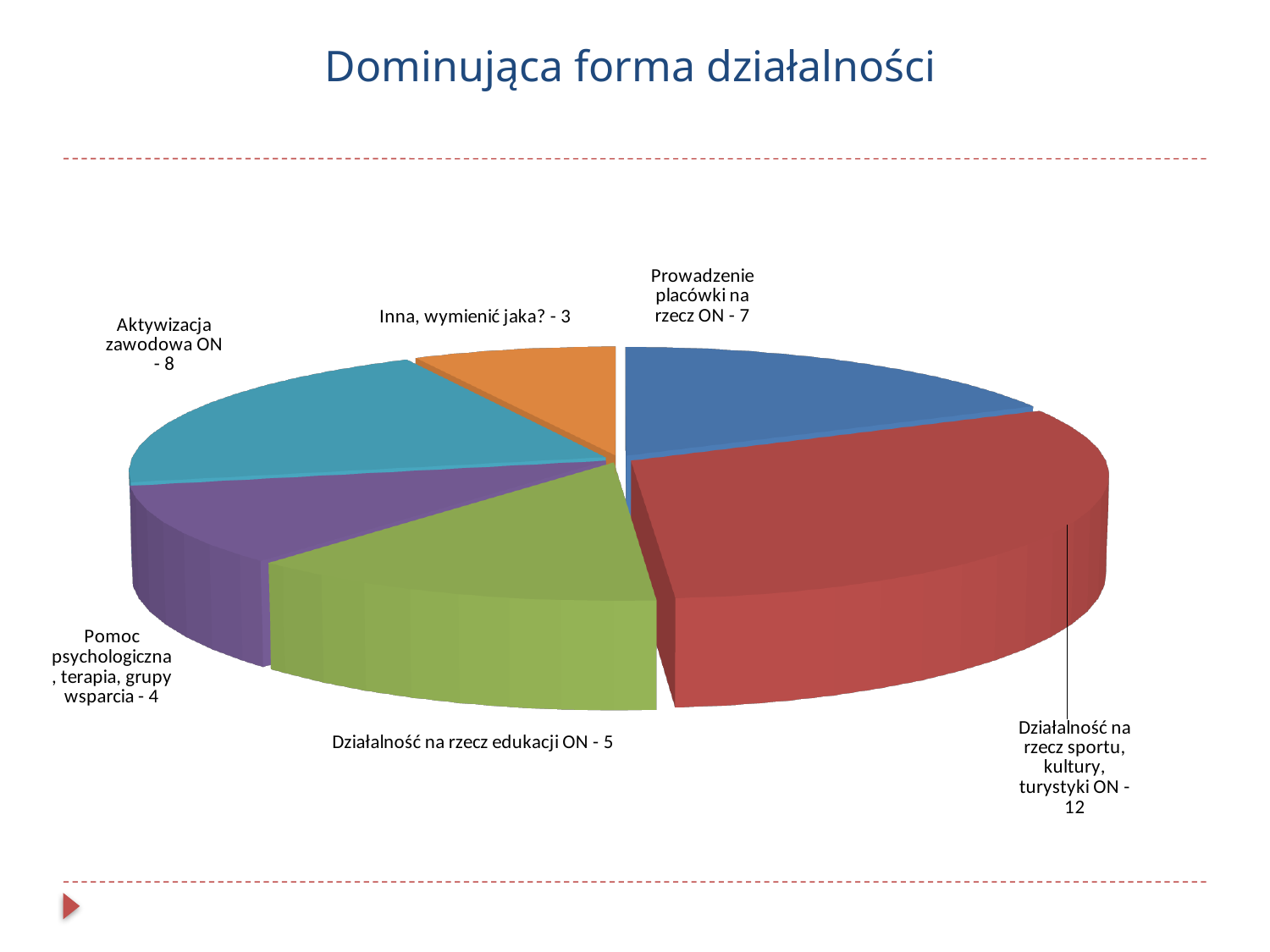
What kind of chart is shown on the slide? Pie chart What is the value for "Pomoc psychologiczna, terapia, grupy wsparcia"? 4 What is the difference between the values for "Działalność na rzecz sportu, kultury, turystyki ON" and "Działalność na rzecz edukacji ON"? 7 What is the value for "Prowadzenie placówki na rzecz ON"? 7 What is the value for "Działalność na rzecz sportu, kultury, turystyki ON"? 12 Which is larger: "Aktywizacja zawodowa ON" or "Prowadzenie placówki na rzecz ON"? Aktywizacja zawodowa ON What is the total of all slice values in the pie chart? 39 What is the value for "Aktywizacja zawodowa ON"? 8 What is the title of the chart? Dominująca forma działalności How many slices does the pie chart have? 6 Which category has the largest slice? Działalność na rzecz sportu, kultury, turystyki ON Which category has the smallest slice? Inna, wymienić jaka?